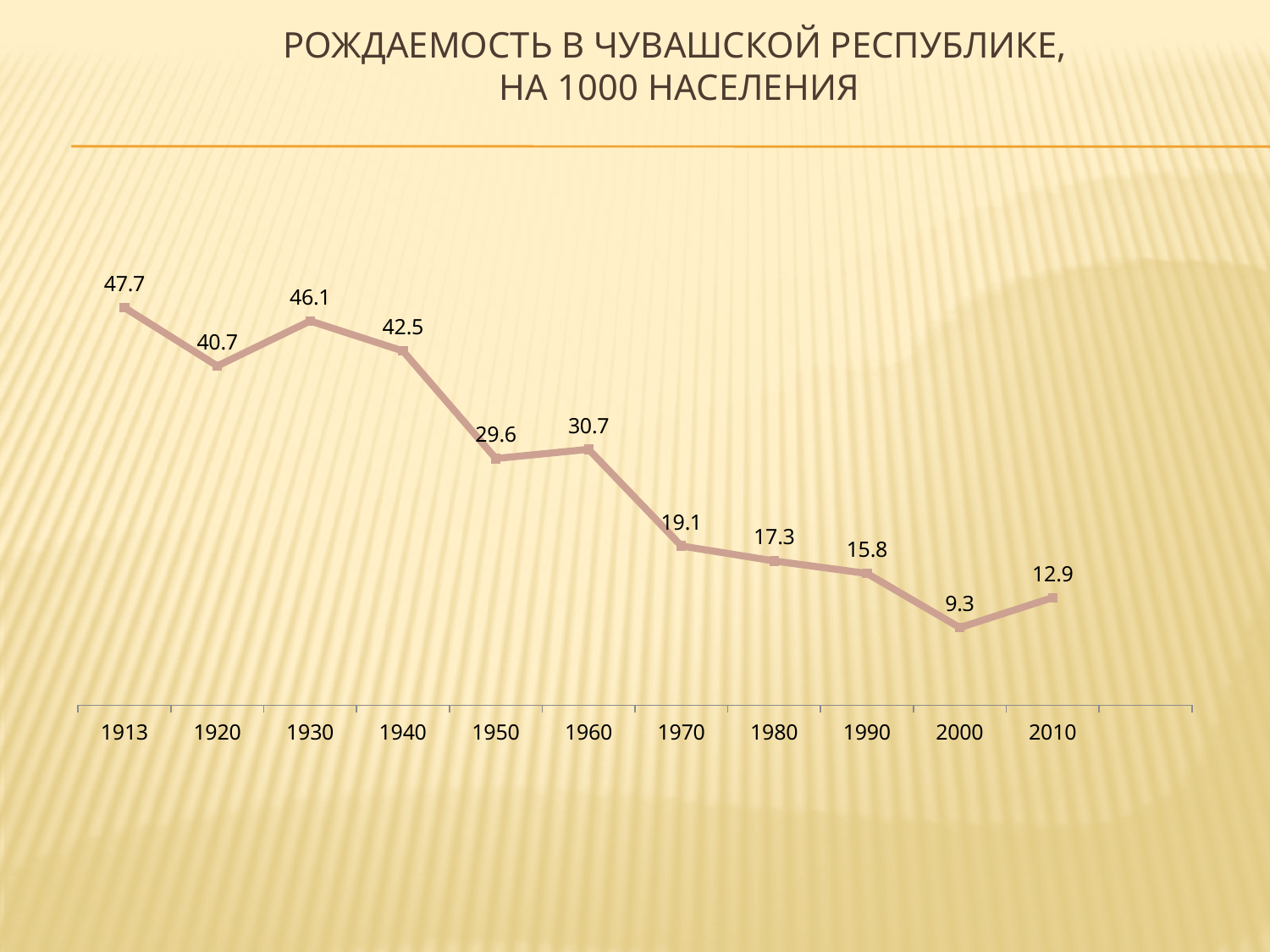
What type of chart is shown on the slide? line chart Which year has a higher birth rate, 1920 or 1930? 1930 How many years are plotted on the chart? 11 What is the difference between the birth rate in 1913 and in 2010? 34.8 What is the birth rate value for 1913? 47.7 Which year has the highest birth rate? 1913 Which year has the lowest birth rate? 2000 What is the overall trend of the birth rate from 1913 to 2010? falling What is the difference between the birth rate in 1960 and in 1970? 11.6 What is the birth rate value for 2010? 12.9 What is the birth rate value for 1950? 29.6 What is the title of the chart? Рождаемость в Чувашской Республике, на 1000 населения